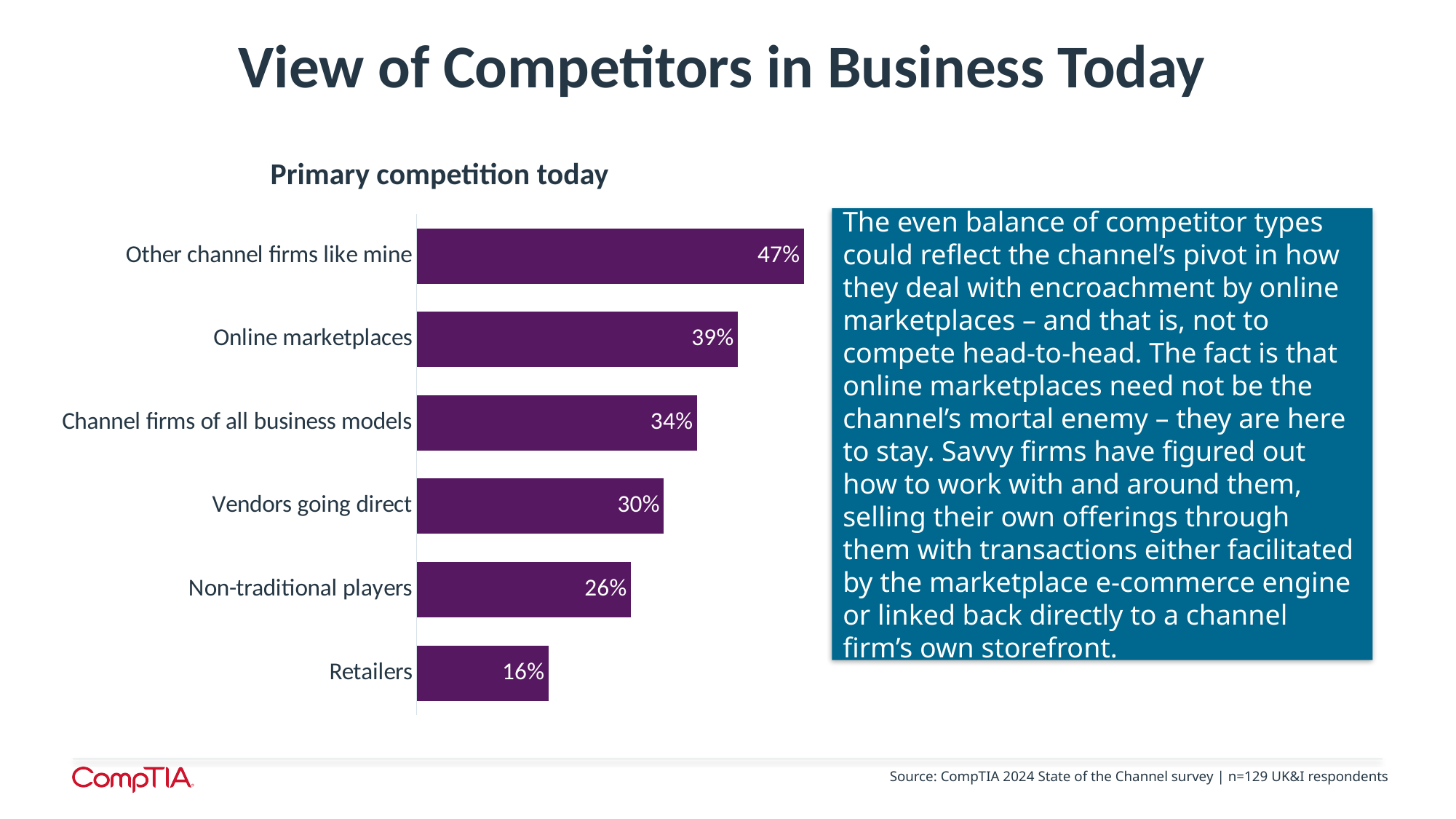
What kind of chart is shown on the slide? Bar chart What is the difference between the values for Other channel firms like mine and Online marketplaces? 8% What is the value shown for Retailers? 16% What is the title of the chart? Primary competition today How many categories are shown in the chart? 6 What is the value shown for Online marketplaces? 39% Which category has the highest value in the chart? Other channel firms like mine What is the value shown for Vendors going direct? 30% Which is larger: the value for Vendors going direct or the value for Non-traditional players? Vendors going direct What is the difference between the values for Channel firms of all business models and Non-traditional players? 8% What percentage of respondents cite Other channel firms like mine as their primary competition today? 47% Which category has the lowest value in the chart? Retailers